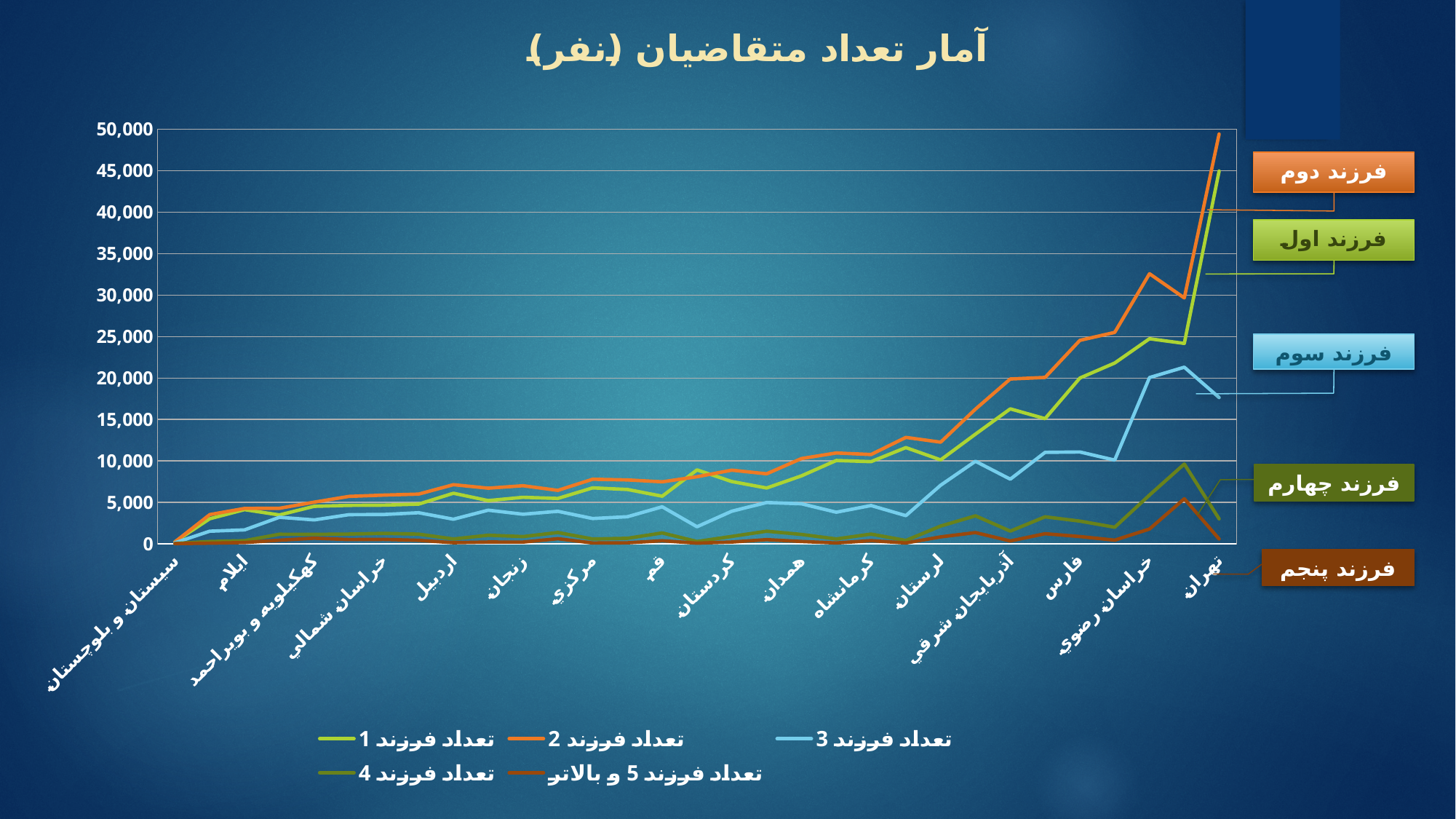
What kind of chart is shown on the slide? line chart Do the values of تعداد فرزند 2 generally rise or fall from left to right along the x axis? rise What is the title of the chart? آمار تعداد متقاضیان (نفر) Which colour is used for the series تعداد فرزند 2 in the legend? orange For the series تعداد فرزند 2, which category has the highest value? تهران Is the value of تعداد فرزند 4 for تهران greater or less than 5,000? less At تهران, which is larger: تعداد فرزند 2 or تعداد فرزند 1? تعداد فرزند 2 Is the value of تعداد فرزند 2 for تهران greater or less than 45,000? greater Which series has the lowest value at تهران? تعداد فرزند 5 و بالاتر Is the value of تعداد فرزند 3 for تهران greater or less than 20,000? less How many series does the legend list? 5